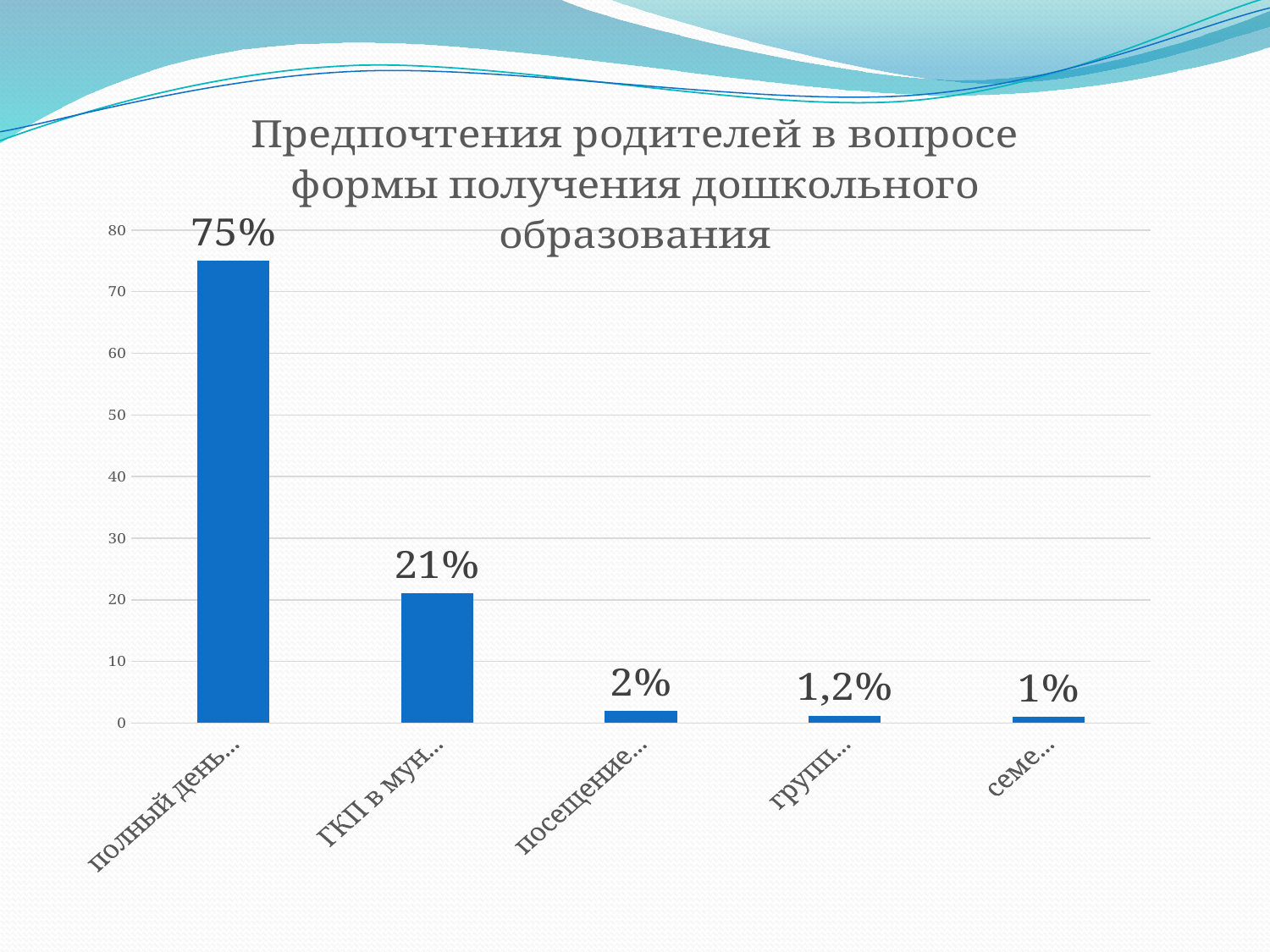
What value is shown for the second bar, labelled "ГКП в мун..."? 21% What value is shown for the third bar, labelled "посещение..."? 2% What is the difference between the values for "полный день..." and "ГКП в мун..."? 54% What kind of chart is shown on the slide? Bar chart What value is shown for the last bar, labelled "семе..."? 1% What value is shown for the fourth bar, labelled "групп..."? 1,2% What value is shown for the first bar, labelled "полный день..."? 75% Which is larger, the value for "ГКП в мун..." or the value for "посещение..."? ГКП в мун... Which category has the lowest value? семе... Which category has the highest value? полный день... How many categories are plotted in the chart? 5 Do the values rise or fall from left to right along the x axis? Fall